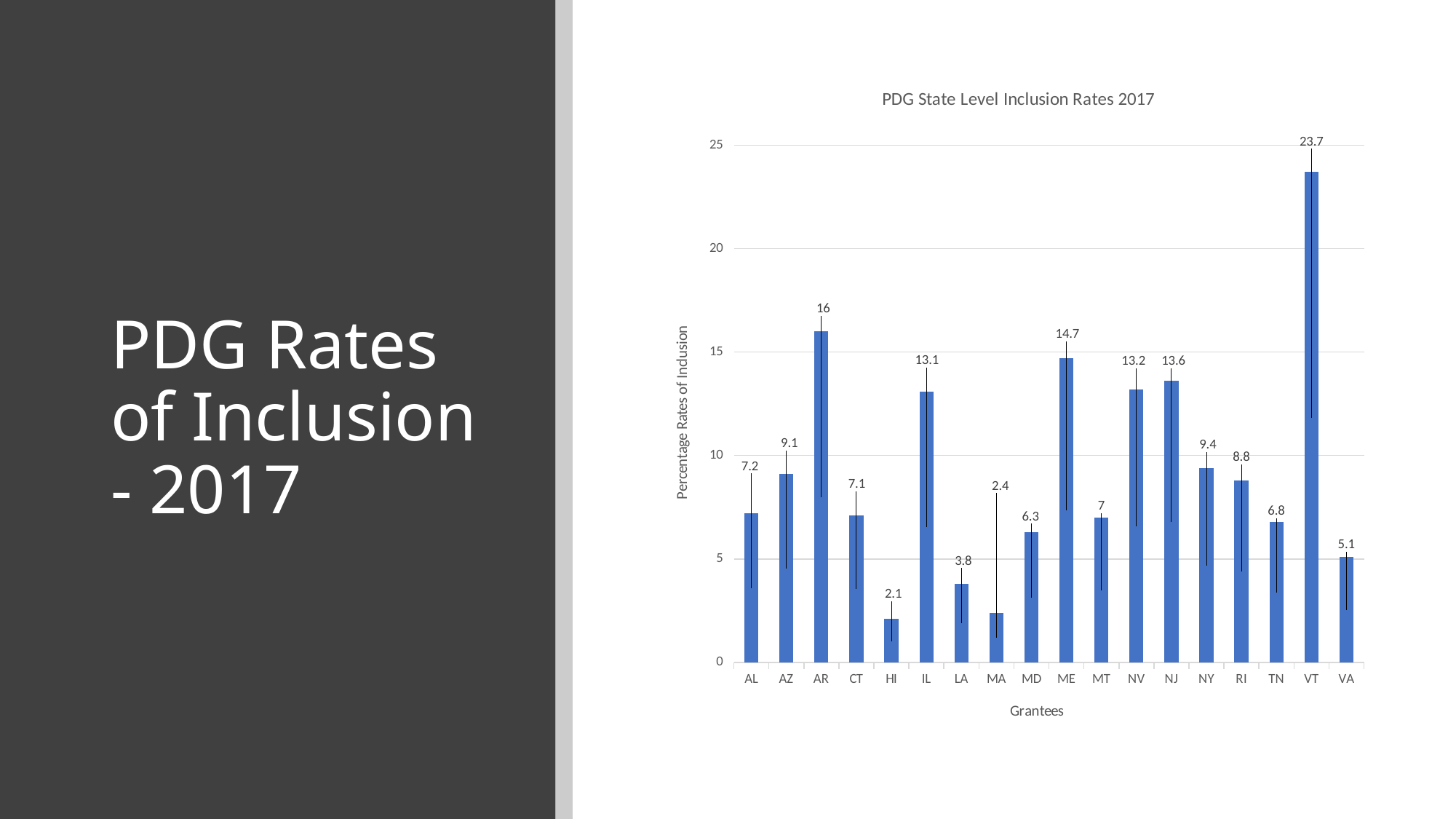
What is the inclusion rate for MD? 6.3 How many grantees are shown on the x axis? 18 What is the label of the y axis? Percentage Rates of Inclusion What is the title of the chart? PDG State Level Inclusion Rates 2017 Which grantee has the highest inclusion rate? VT Which has a higher inclusion rate, NV or NJ? NJ Which grantee has the lowest inclusion rate? HI What is the difference between the inclusion rates of AR and CT? 8.9 What kind of chart is this? Bar chart What is the inclusion rate for VT? 23.7 What is the inclusion rate for ME? 14.7 Is the value for IL greater or less than 10? greater